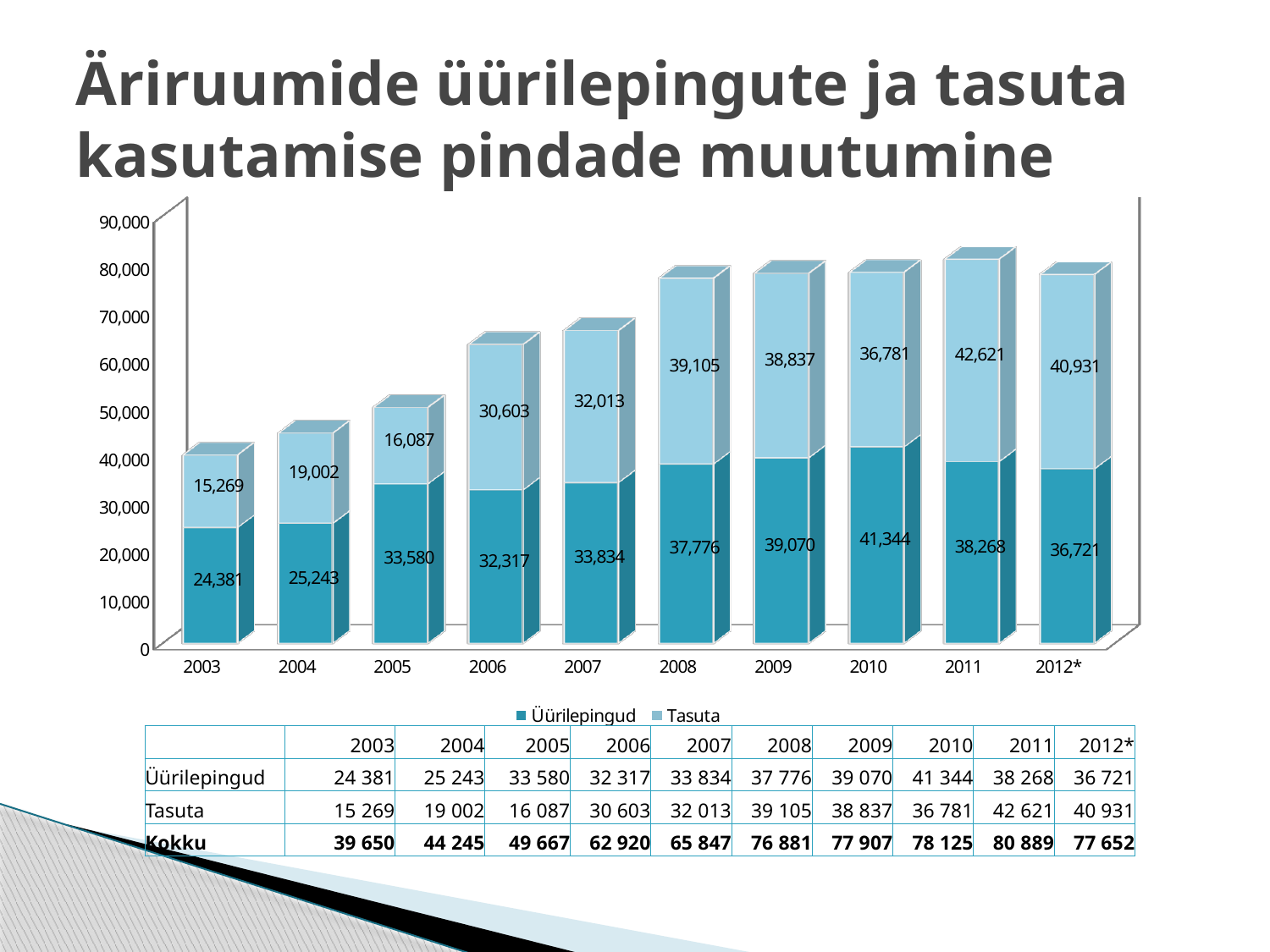
What is the value of Üürilepingud for 2003? 24,381 In 2008, which is larger: Üürilepingud or Tasuta? Tasuta What is the value of Tasuta for 2011? 42,621 What is the difference between Üürilepingud and Tasuta in 2010? 4,563 Is the total height of the 2006 stacked bar greater or less than 60,000? greater In which year is the Üürilepingud value highest? 2010 What is the value of Tasuta for 2012*? 40,931 What is the total of the stacked bar for 2011? 80 889 How many years are shown on the x axis? 10 In which year is the Tasuta value lowest? 2003 How many series does the legend list? 2 What kind of chart is shown on the slide? stacked bar chart